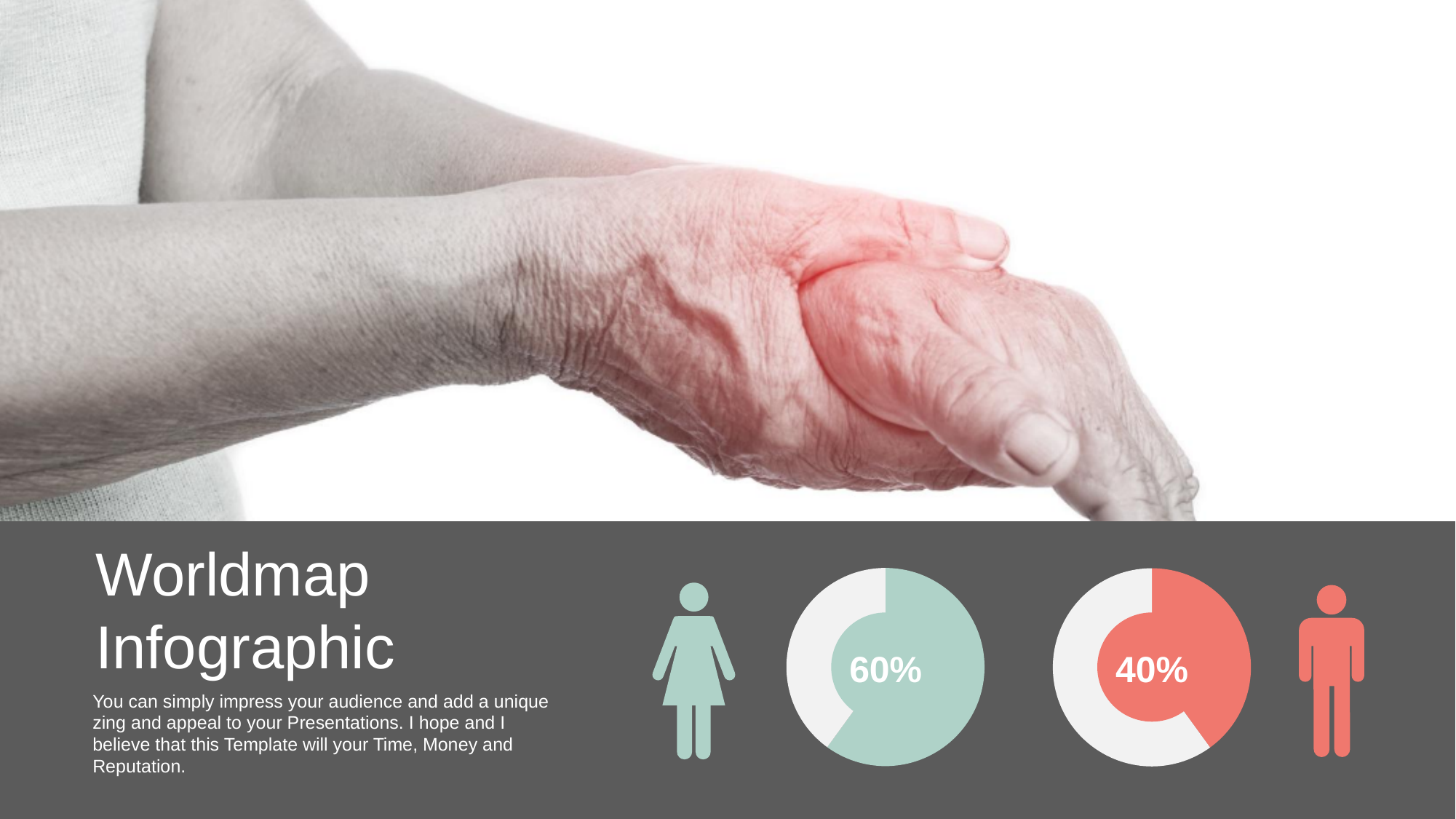
What colour is the filled slice of the right pie chart? Red How many pie charts are on the slide? 2 What colour is the filled slice of the left pie chart? Green What is the difference between the value on the left pie chart (60%) and the value on the right pie chart (40%)? 20 percentage points What kind of charts are shown on the slide? Pie charts Is the value on the right pie chart greater or less than 50%? less On the right pie chart next to the male figure, what percentage is shown? 40% Is the value on the left pie chart greater or less than 50%? greater On the right pie chart, what share of the pie does the coloured slice represent? 40% Which pie chart shows the larger value, the left one next to the female figure or the right one next to the male figure? The left one (60%) On the left pie chart next to the female figure, what percentage is shown? 60% On the left pie chart, what share of the pie does the coloured slice represent? 60%